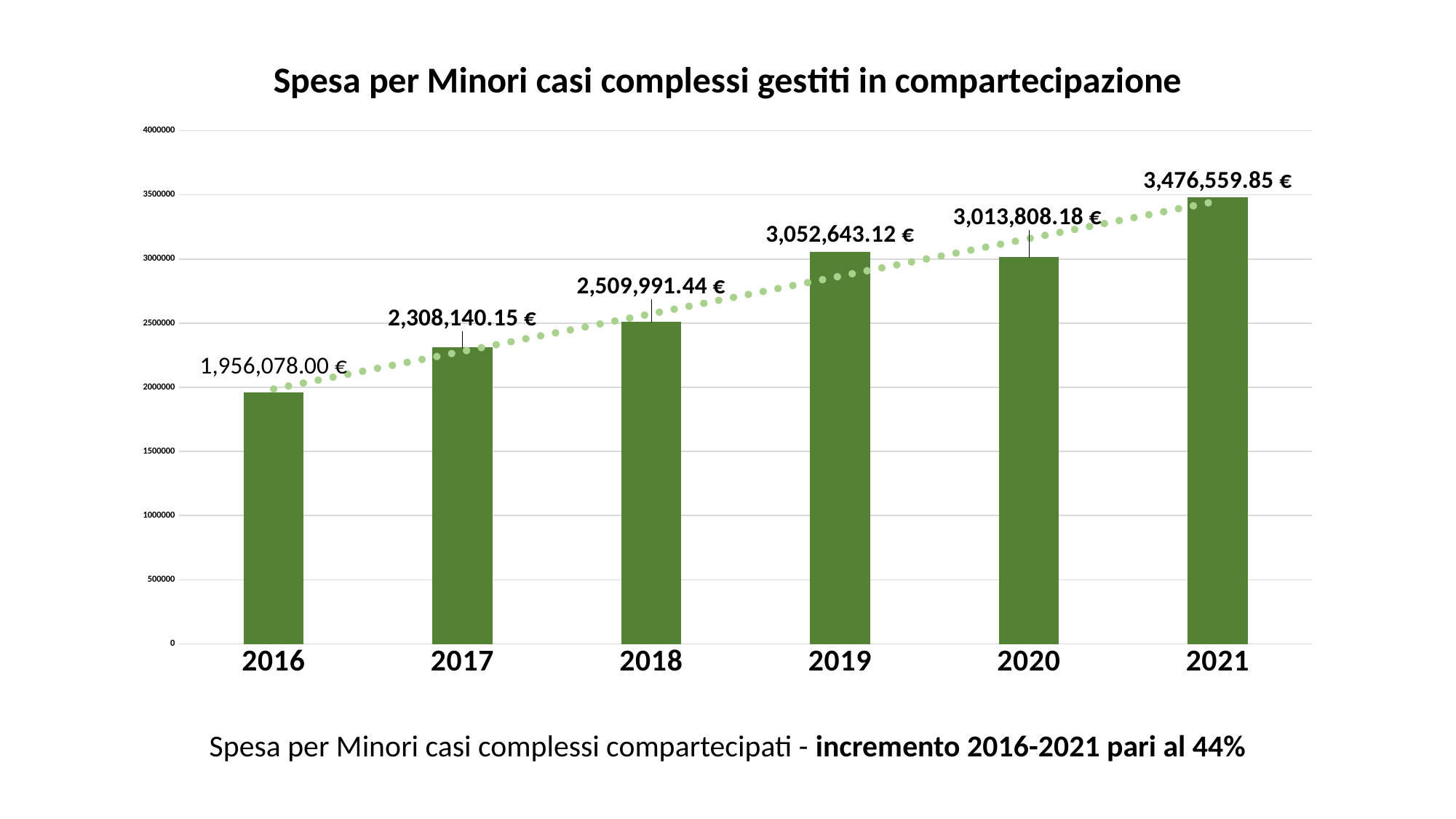
Do the values generally rise or fall from 2016 to 2021? rise Which year has the highest value? 2021 Which year has the lowest value? 2016 Is the value for 2021 greater or less than 3000000? greater What is the value for 2019? 3,052,643.12 € What is the difference between the values for 2019 and 2020? 38,834.94 € What is the difference between the values for 2021 and 2016? 1,520,481.85 € What is the value for 2016? 1,956,078.00 € What is the value for 2021? 3,476,559.85 € Which is larger, the value for 2019 or the value for 2020? 2019 What kind of chart is this? bar chart How many years are shown on the x axis? 6